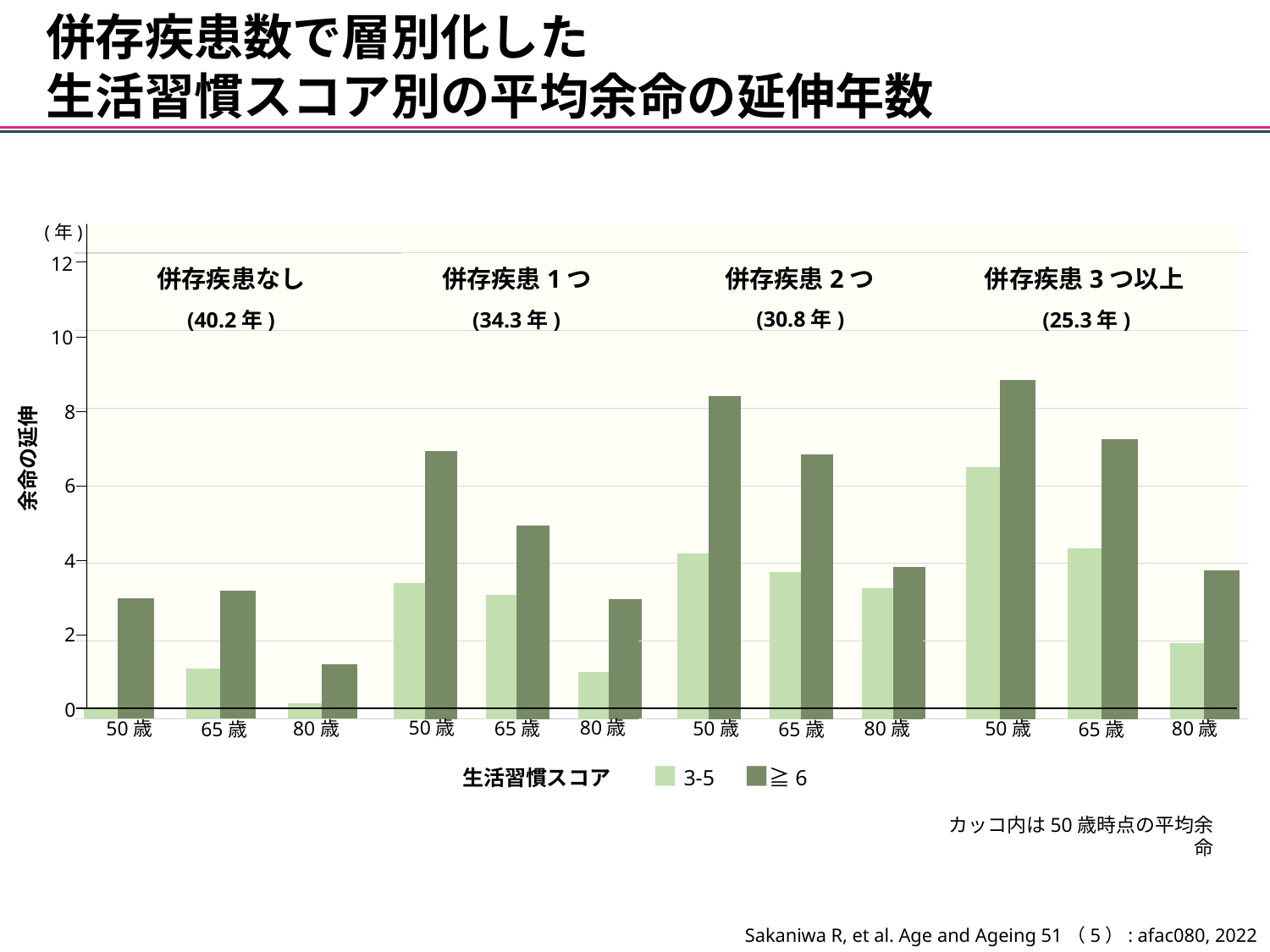
In the 併存疾患1つ group, which is larger for the ≧6 series: the value at 50歳 or at 65歳? 50歳 Among the 3-5 series bars, which group and age has the highest value? 併存疾患3つ以上, 50歳 Is the value for the 3-5 series at 65歳 in the 併存疾患1つ group greater or less than 2? greater What kind of chart is shown on the slide? bar chart How many series does the legend list for 生活習慣スコア? 2 Is the value for the 3-5 series at 50歳 in the 併存疾患3つ以上 group greater or less than 6? greater What are the two legend entries for 生活習慣スコア? 3-5 and ≧6 What average remaining life expectancy at age 50 is shown in parentheses for the 併存疾患なし group? 40.2年 How many comorbidity groups (併存疾患) are shown along the x axis? 4 Is the value for the ≧6 series at 80歳 in the 併存疾患なし group greater or less than 2? less In the 併存疾患1つ group, do the ≧6 series values rise or fall from 50歳 to 80歳? fall